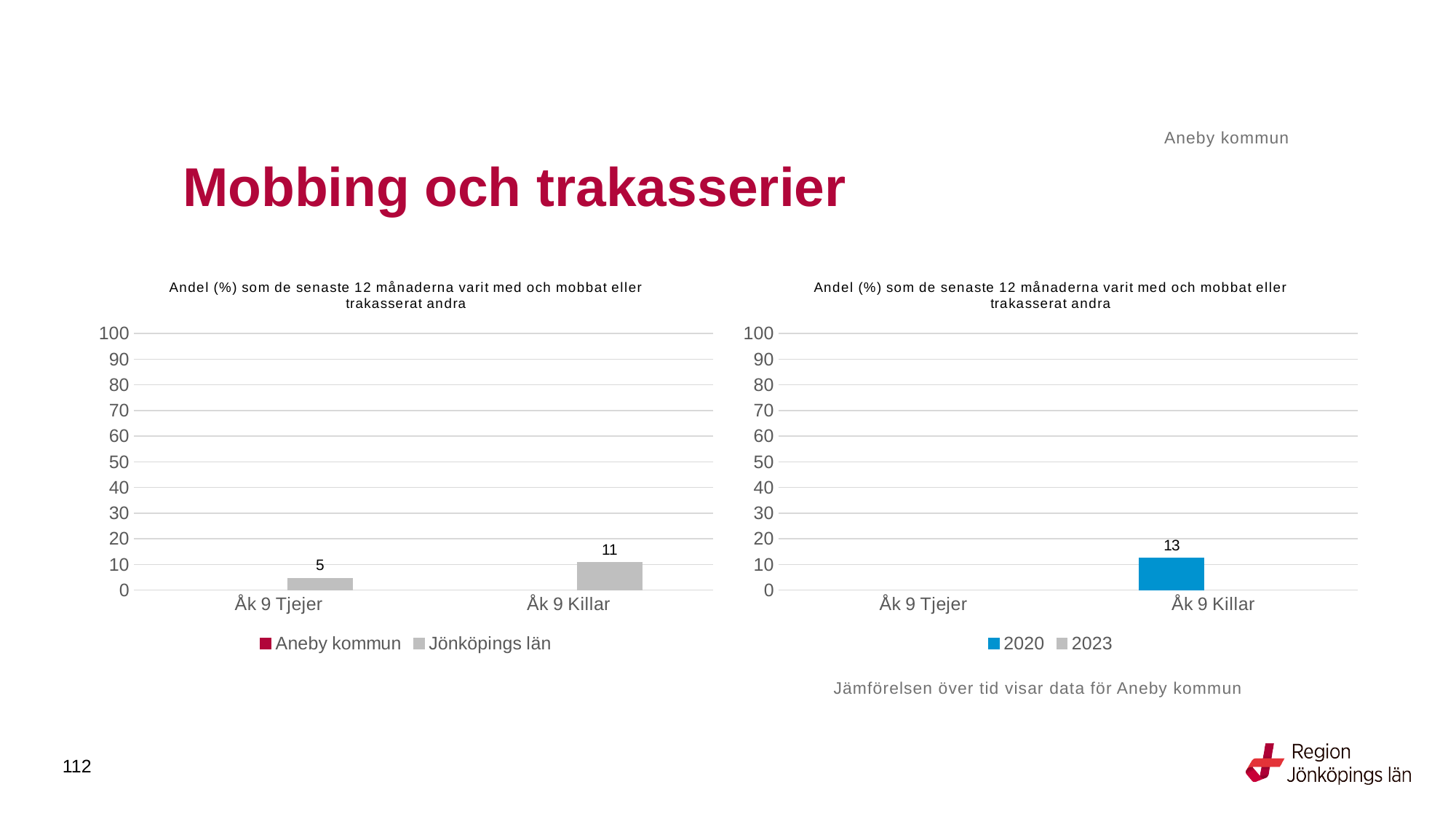
In the left chart, is the Jönköpings län value for Åk 9 Killar greater or less than 20? less In the left chart, what is the difference between the Jönköpings län values for Åk 9 Killar and Åk 9 Tjejer? 6 Which two series are listed in the legend of the right chart? 2020 and 2023 In the right chart, what is the value for 2020 for Åk 9 Killar? 13 How many categories are shown on the x axis of the right chart? 2 In the right chart, is the 2020 value for Åk 9 Killar greater or less than 10? greater What kind of chart is the right chart? Bar chart In the left chart, what is the value for Jönköpings län for Åk 9 Tjejer? 5 How many series does the legend of the left chart list? 2 In the left chart, what is the value for Jönköpings län for Åk 9 Killar? 11 What is the highest value shown on the y axis of the left chart? 100 In the left chart, which category has the higher Jönköpings län value, Åk 9 Tjejer or Åk 9 Killar? Åk 9 Killar